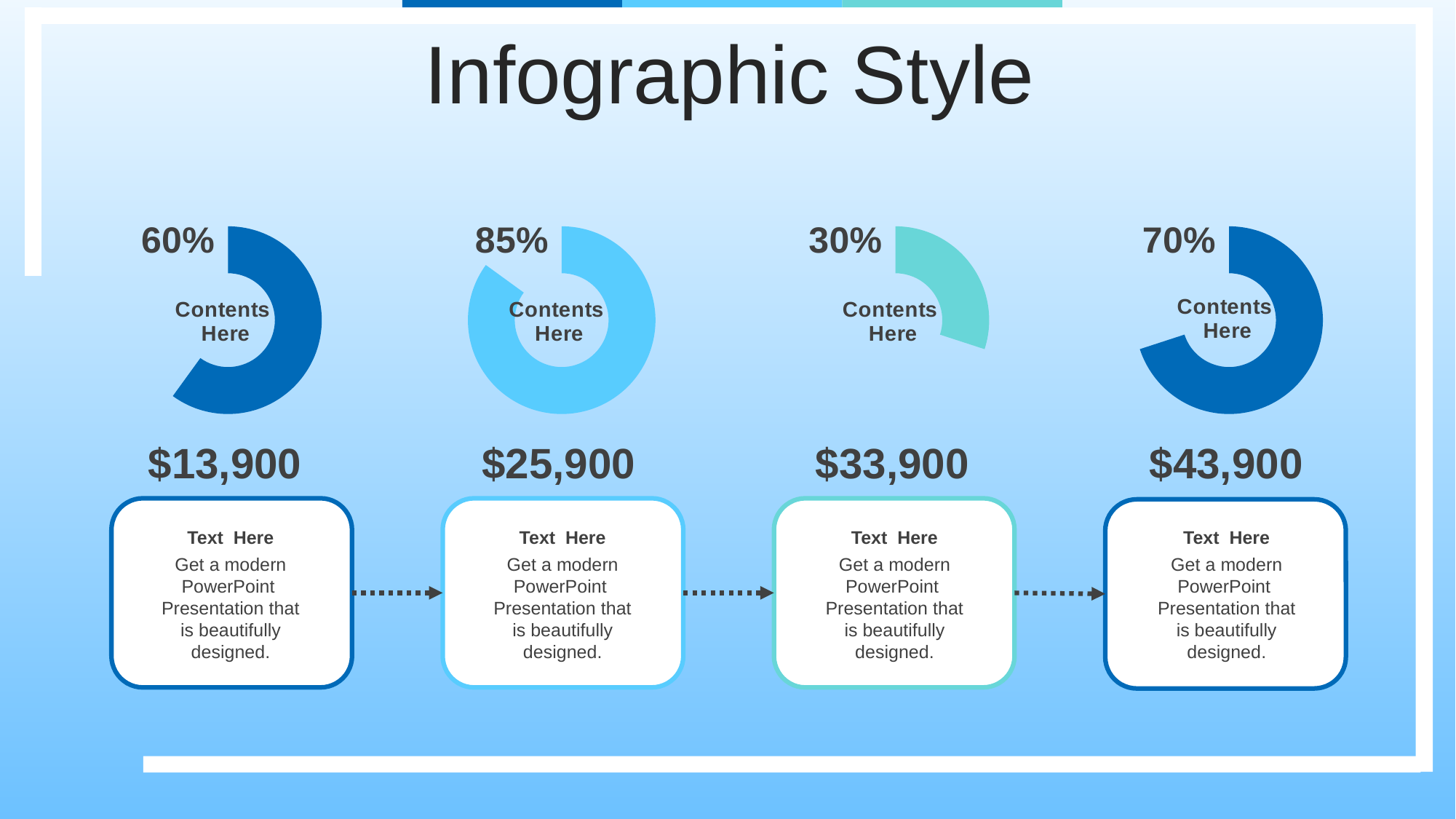
Which of the four donut charts shows the highest percentage? The second from the left (85%) What percentage is shown on the third donut chart from the left? 30% How many donut charts are shown on the slide? 4 What dollar amount is printed below the third donut chart from the left? $33,900 What percentage is shown on the fourth (rightmost) donut chart? 70% Which of the four donut charts shows the lowest percentage? The third from the left (30%) What kind of chart is used to display the percentages on the slide? Donut chart What is the difference between the percentage on the second donut chart and the percentage on the third donut chart? 55% What percentage is shown on the first (leftmost) donut chart? 60% What colour is the filled ring of the third donut chart from the left? Teal (light green-blue) Which is larger: the percentage on the first donut chart or the percentage on the fourth donut chart? The fourth donut chart (70%) What percentage is shown on the second donut chart from the left? 85%